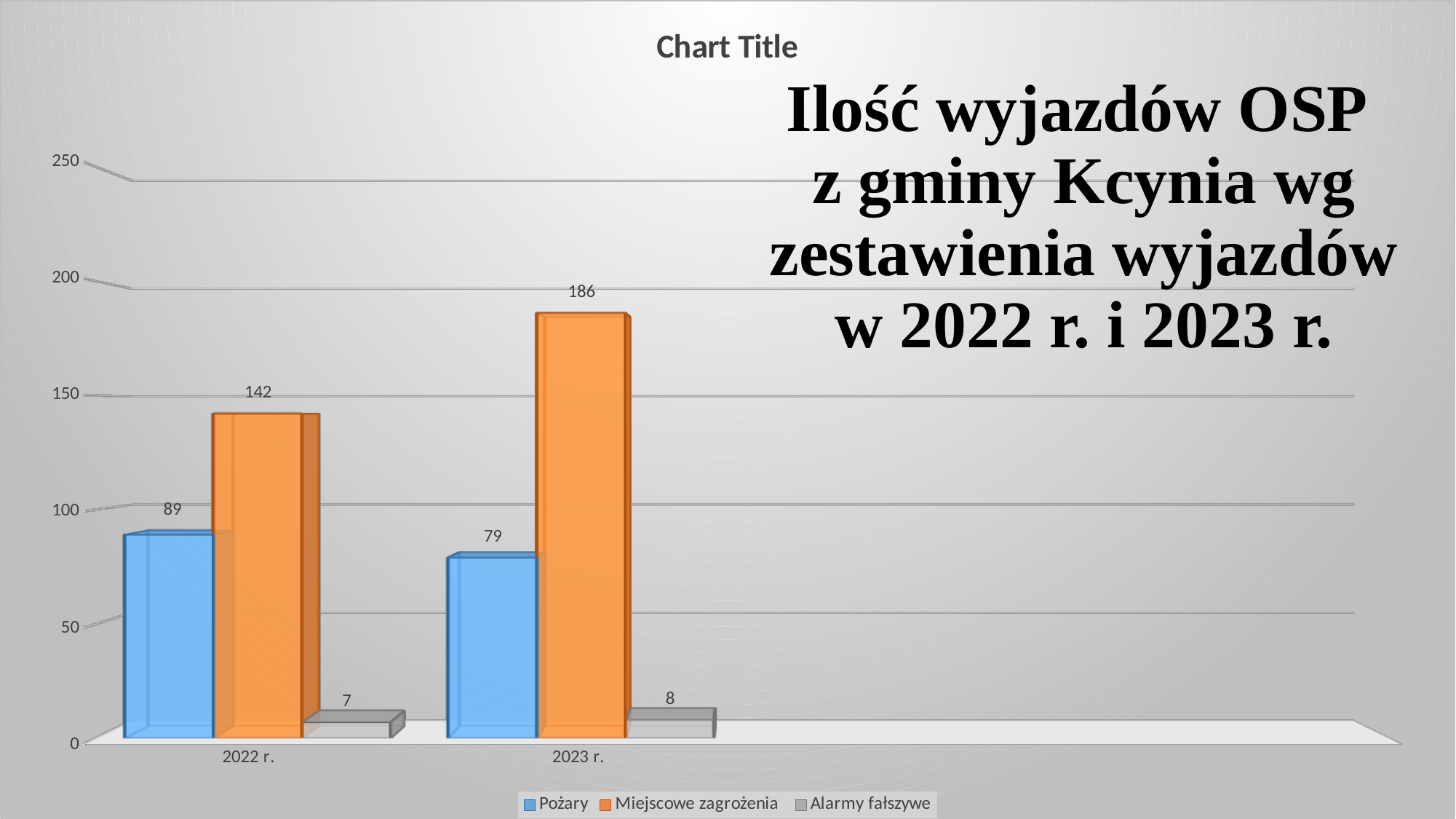
Which is larger: Pożary in 2022 r. or Pożary in 2023 r.? 2022 r. Which series has the lowest value in 2022 r.? Alarmy fałszywe What is the difference between Miejscowe zagrożenia in 2023 r. and in 2022 r.? 44 How many series does the legend list? 3 What is the value for Alarmy fałszywe in 2022 r.? 7 What is the value for Pożary in 2023 r.? 79 What kind of chart is shown? bar chart How many year categories are shown on the x axis? 2 What is the value for Pożary in 2022 r.? 89 What is the value for Miejscowe zagrożenia in 2023 r.? 186 Is the value for Miejscowe zagrożenia in 2022 r. greater or less than 100? greater Which series has the highest value in 2023 r.? Miejscowe zagrożenia